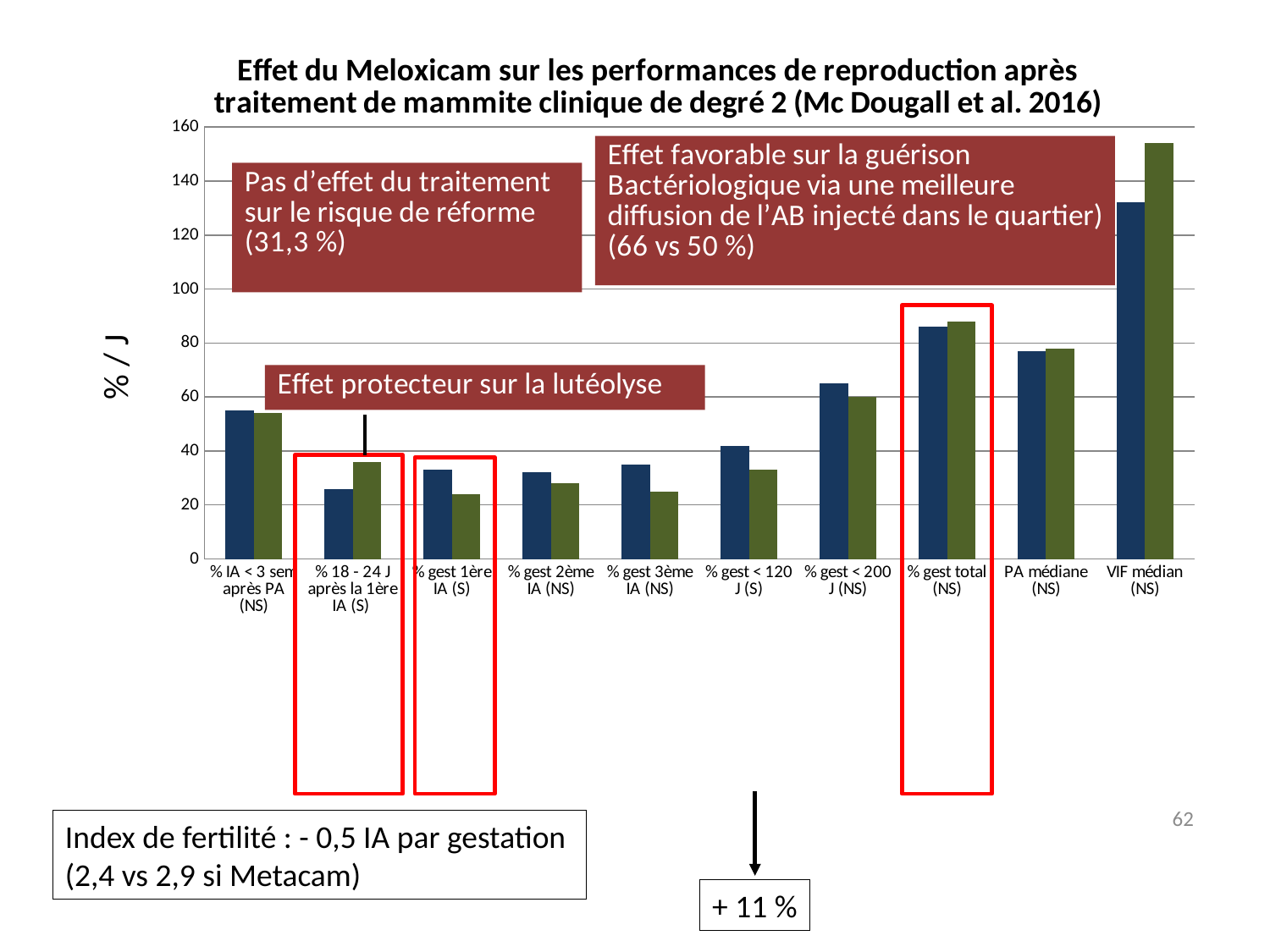
Is the green bar for VIF médian (NS) greater or less than 140? greater For % gest < 120 J (S), which bar is taller, the blue one or the green one? blue What is the highest value shown on the vertical axis of the chart? 160 Is the green bar for % gest 1ère IA (S) greater or less than 40? less For % 18 - 24 J après la 1ère IA (S), which bar is taller, the blue one or the green one? green What kind of chart is shown on the slide? bar chart Is the blue bar for % gest total (NS) greater or less than 80? greater How many bars are plotted for each category in the chart? 2 How many categories are shown along the x axis of the chart? 10 What is the label on the vertical axis of the chart? % / J Which category has the tallest bars in the chart? VIF médian (NS)